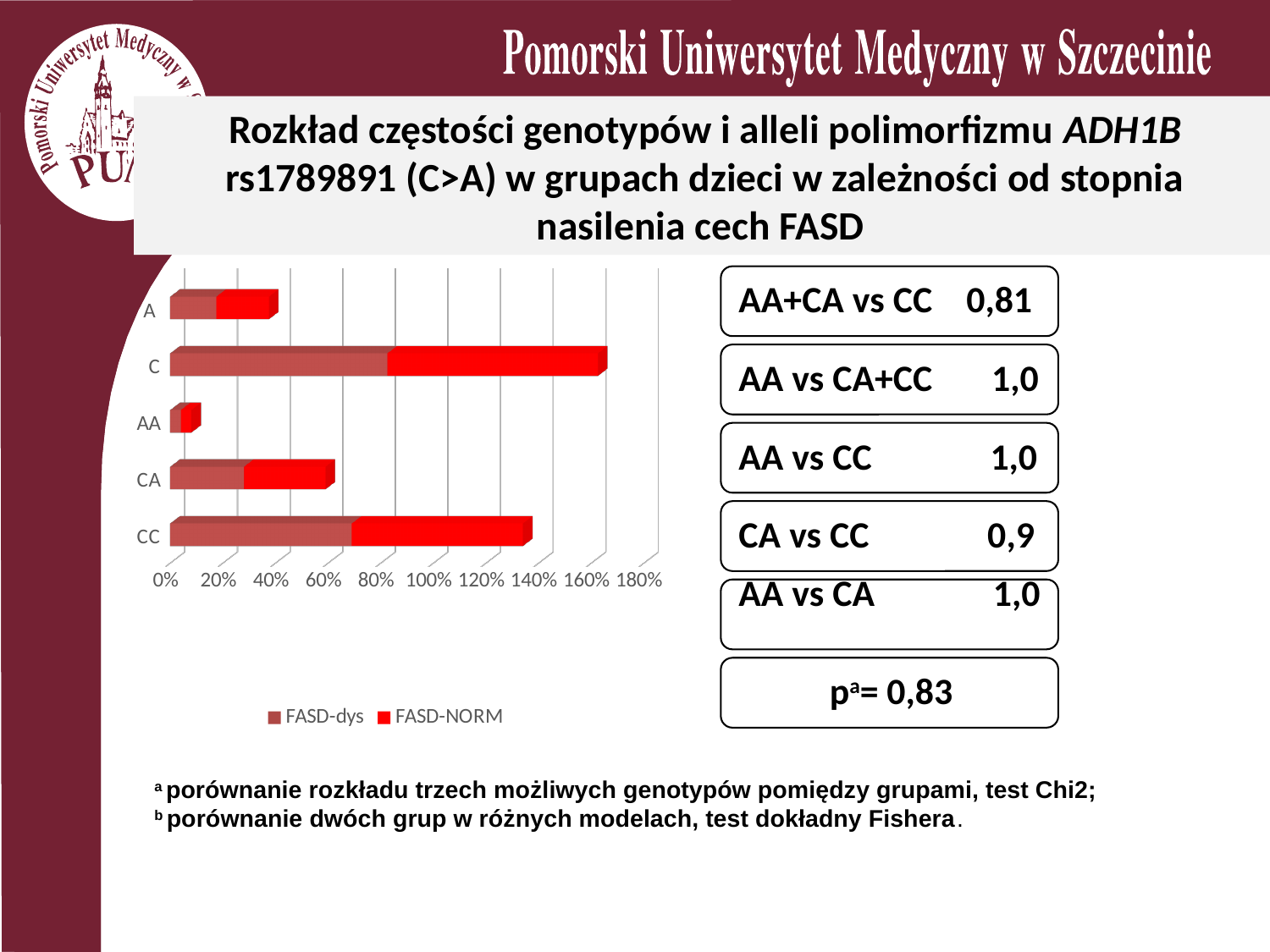
What kind of chart is shown on the slide? bar chart Which category has the longer total bar, A or CA? CA Is the total bar for A greater or less than 60%? less Which category has the longest total bar in the chart? C Is the total bar for C greater or less than 140%? greater Is the total bar for AA greater or less than 20%? less How many categories are shown on the chart's vertical axis? 5 Which category has the shortest total bar in the chart? AA How many series does the chart legend list? 2 Which category has the longer total bar, CC or CA? CC Which two series are listed in the chart legend? FASD-dys and FASD-NORM